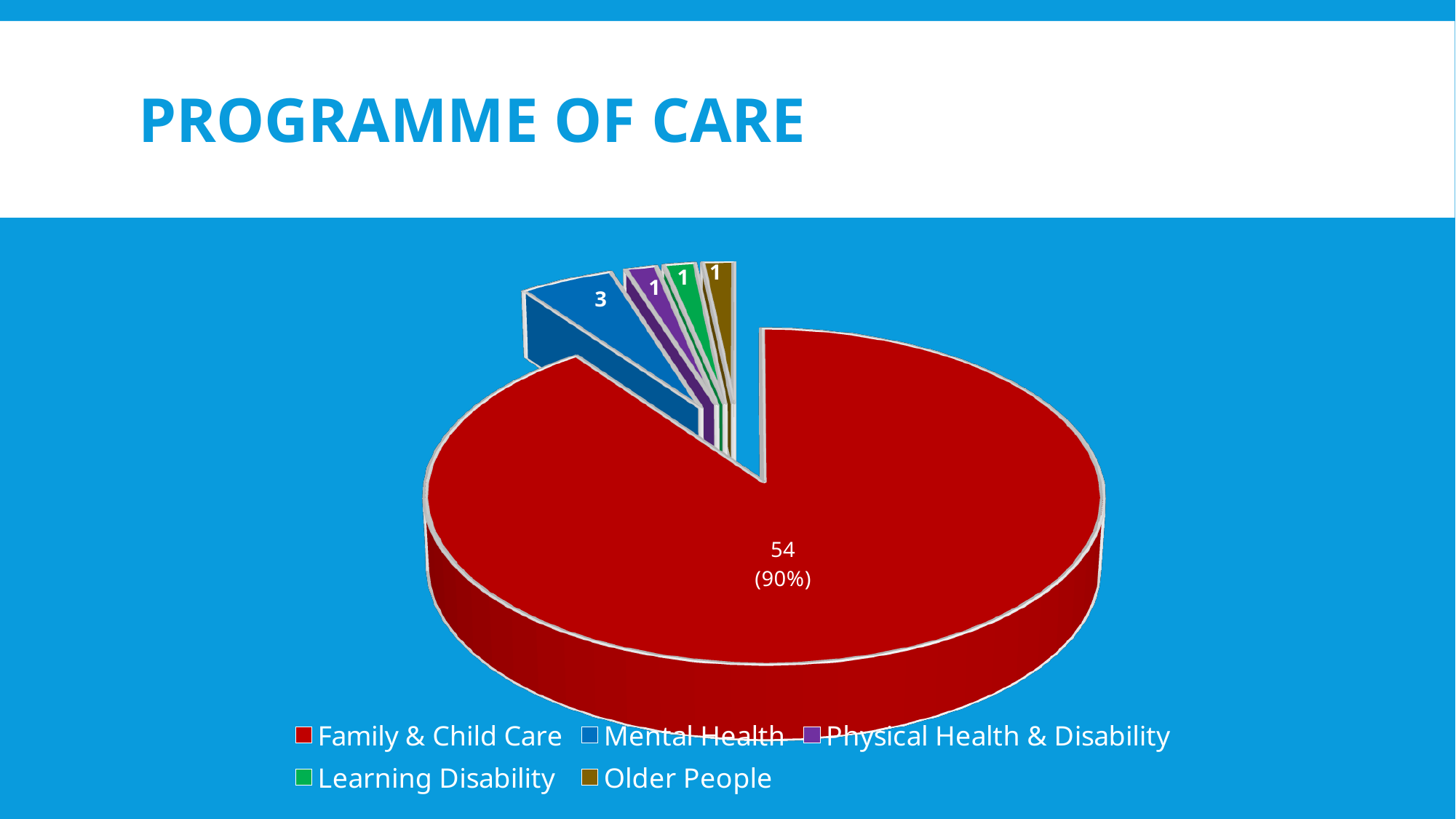
What is the total of all the values in the pie chart? 60 What is the value for Family & Child Care? 54 What is the title of the slide containing the chart? PROGRAMME OF CARE What type of chart is shown on the slide? Pie chart What is the value for Older People? 1 Which category has the largest slice of the pie? Family & Child Care What percentage share is shown for Family & Child Care? 90% What colour is the slice for Physical Health & Disability? Purple How many categories does the pie chart have? 5 Which is larger, the value for Mental Health or the value for Learning Disability? Mental Health What is the value for Mental Health? 3 What is the difference between the values for Family & Child Care and Mental Health? 51